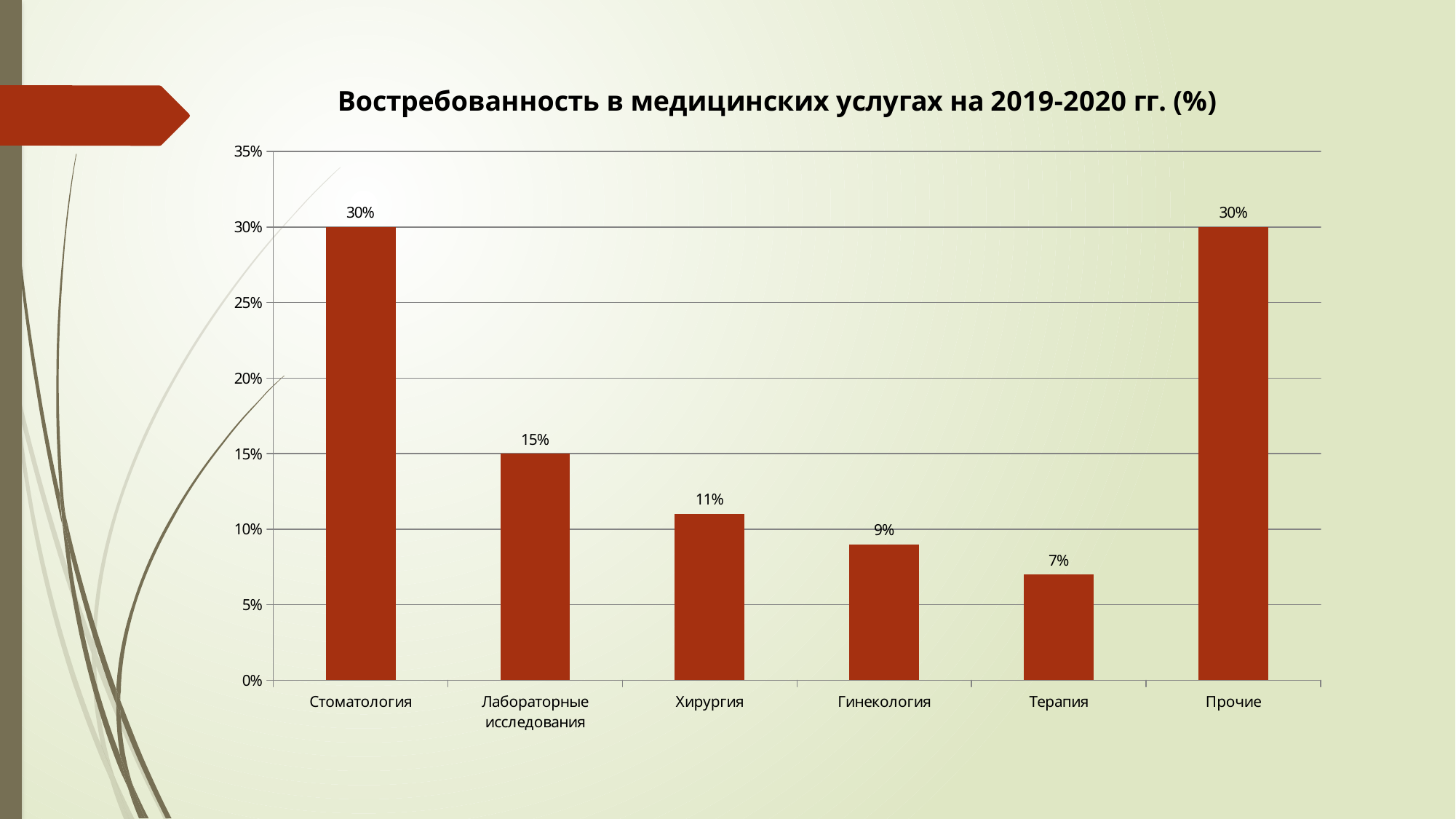
What is the value for Хирургия? 11% What is the value for Стоматология? 30% What is the title of the chart? Востребованность в медицинских услугах на 2019-2020 гг. (%) What is the value for Гинекология? 9% How many categories are shown on the x axis? 6 What is the difference between the values for Лабораторные исследования and Хирургия? 4% What kind of chart is shown on the slide? bar chart Which category has the lowest value? Терапия Which is larger, the value for Гинекология or the value for Терапия? Гинекология What is the difference between the values for Стоматология and Терапия? 23% Which two categories share the highest value of 30%? Стоматология and Прочие What is the value for Лабораторные исследования? 15%